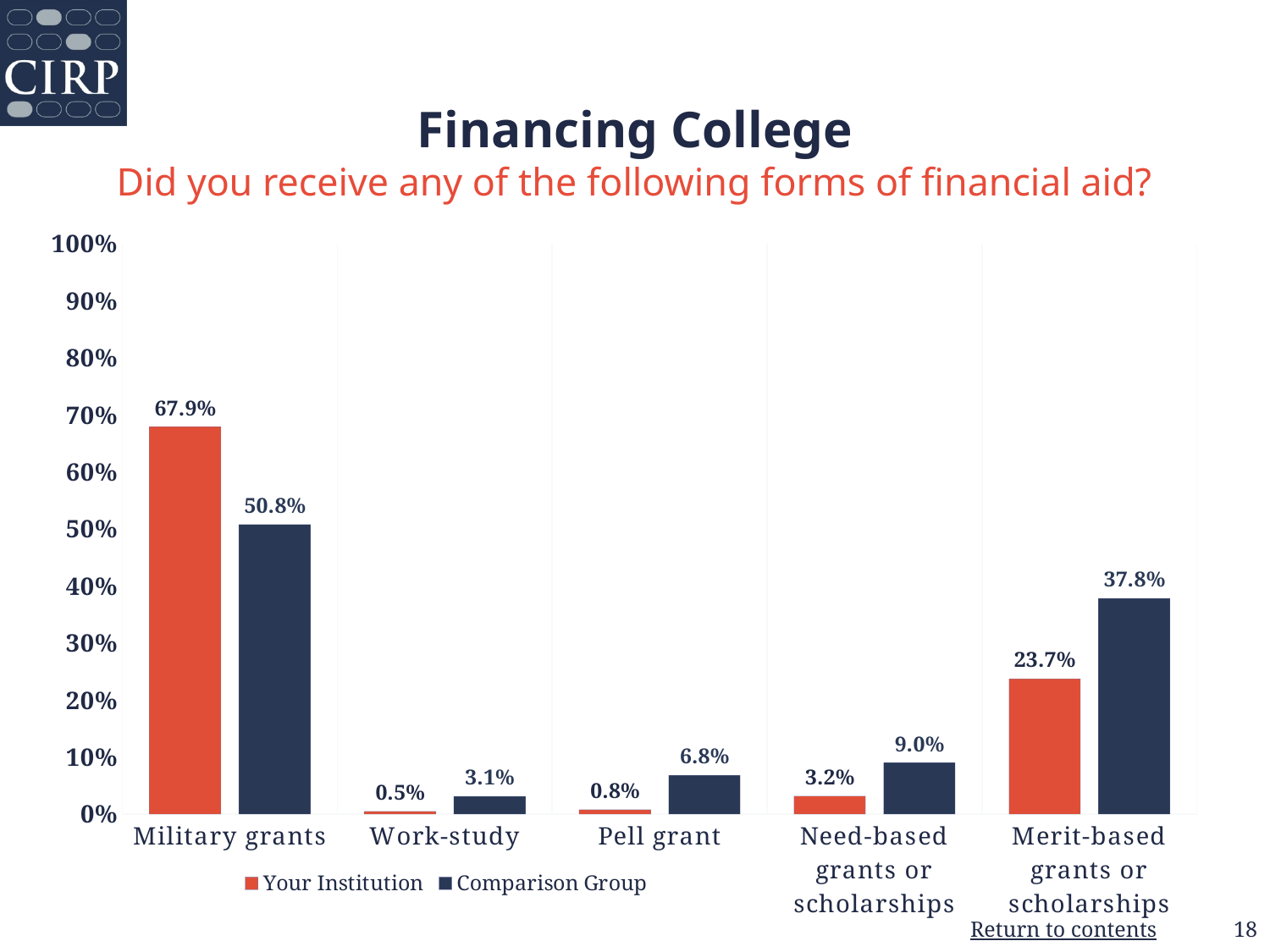
Is the Comparison Group value for Merit-based grants or scholarships greater or less than 40%? less What percentage of Your Institution received Military grants? 67.9% Which form of financial aid has the highest value for the Comparison Group? Military grants What is the difference between Your Institution and the Comparison Group for Military grants? 17.1% What kind of chart is shown on the slide? Bar chart What colour represents Your Institution in the chart? Orange Which form of financial aid has the lowest value for Your Institution? Work-study How many series does the legend list? 2 How many forms of financial aid are shown on the x axis? 5 What is the Comparison Group value for Merit-based grants or scholarships? 37.8% Which is larger for Need-based grants or scholarships: Your Institution or the Comparison Group? Comparison Group What is the Your Institution value for Pell grant? 0.8%